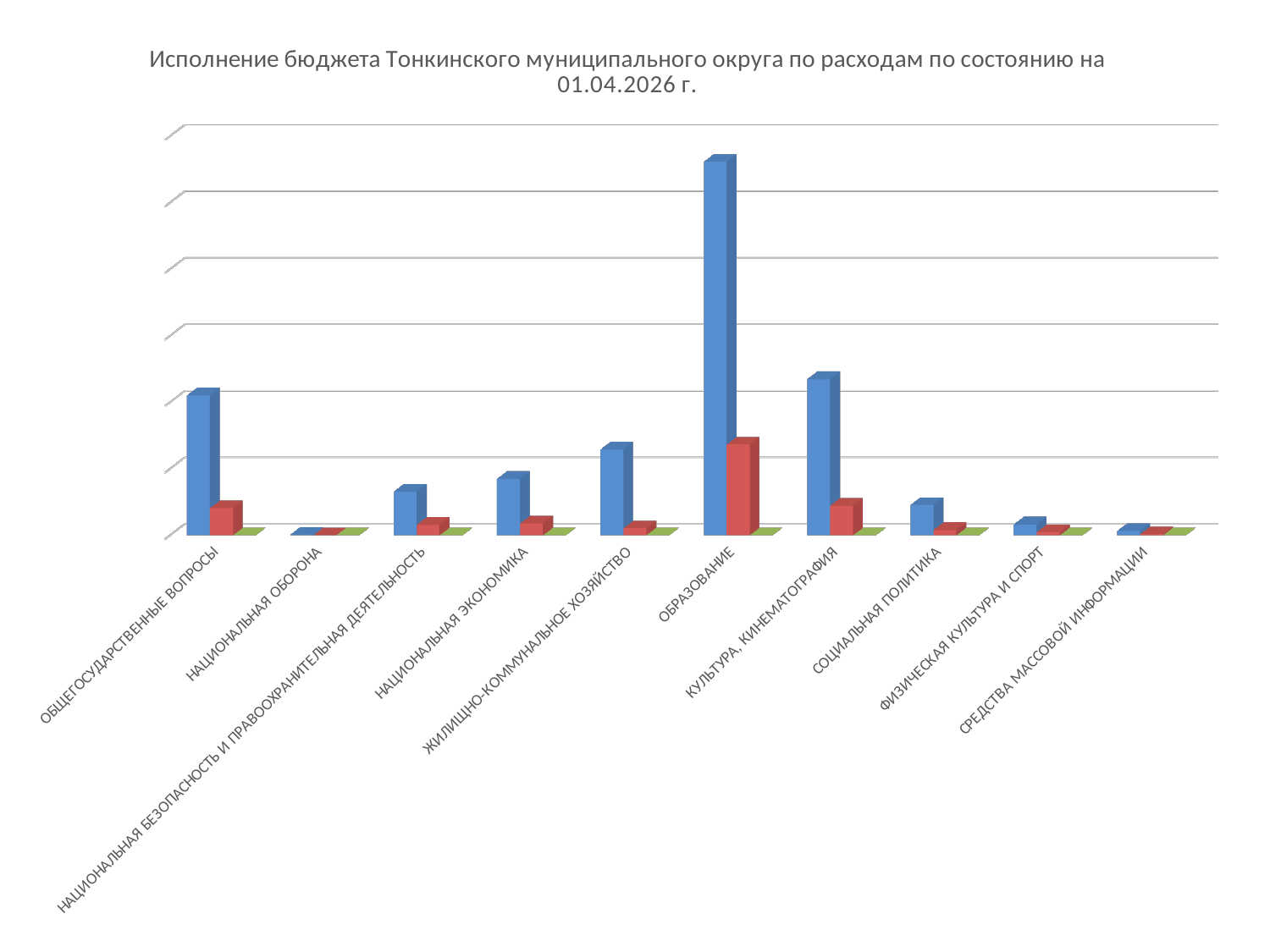
Which category has the tallest red bar? ОБРАЗОВАНИЕ Which category has the second tallest blue bar? КУЛЬТУРА, КИНЕМАТОГРАФИЯ Which has the taller blue bar: ОБРАЗОВАНИЕ or КУЛЬТУРА, КИНЕМАТОГРАФИЯ? ОБРАЗОВАНИЕ Which has the taller blue bar: СОЦИАЛЬНАЯ ПОЛИТИКА or ФИЗИЧЕСКАЯ КУЛЬТУРА И СПОРТ? СОЦИАЛЬНАЯ ПОЛИТИКА Which category has the tallest blue bar? ОБРАЗОВАНИЕ What is the title of the chart? Исполнение бюджета Тонкинского муниципального округа по расходам по состоянию на 01.04.2026 г. How many differently coloured bars are drawn for each category? 3 For ОБРАЗОВАНИЕ, which bar is taller: the blue one or the red one? The blue one How many expenditure categories are shown along the x axis? 10 What kind of chart is shown on the slide? Bar chart